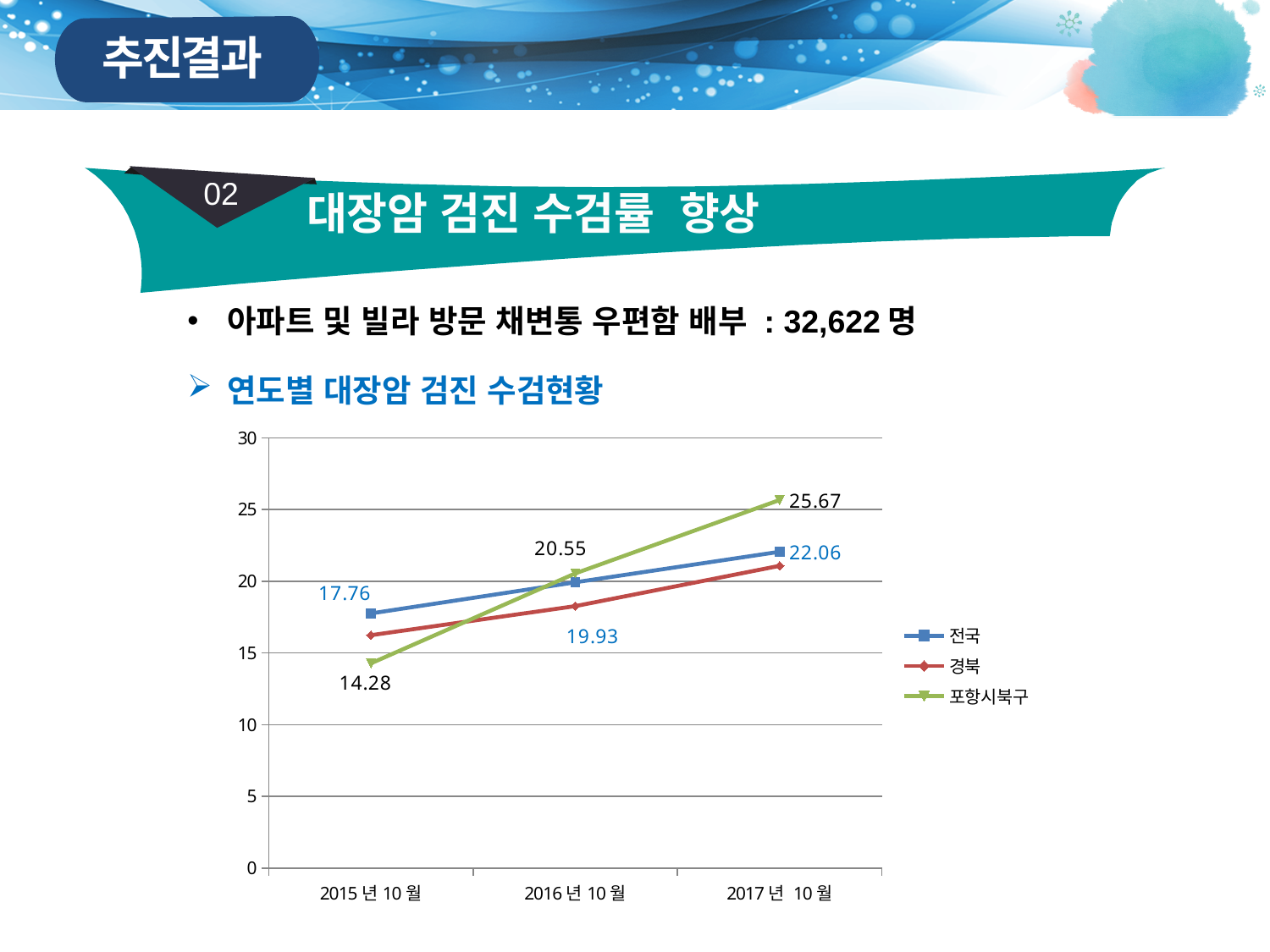
What is the value for 포항시북구 in 2016년 10월? 20.55 What kind of chart is shown on the slide? line chart Is the value for 경북 in 2017년 10월 greater or less than 20? greater How many series does the legend list? 3 By how much did the 포항시북구 value increase from 2015년 10월 to 2017년 10월? 11.39 Which series has the highest value in 2017년 10월? 포항시북구 Does the 포항시북구 series rise or fall from 2015년 10월 to 2017년 10월? rise What is the value for 전국 in 2017년 10월? 22.06 Which series has the lowest value in 2015년 10월? 포항시북구 What is the value for 전국 in 2015년 10월? 17.76 What is the value for 포항시북구 in 2017년 10월? 25.67 What is the value for 포항시북구 in 2015년 10월? 14.28